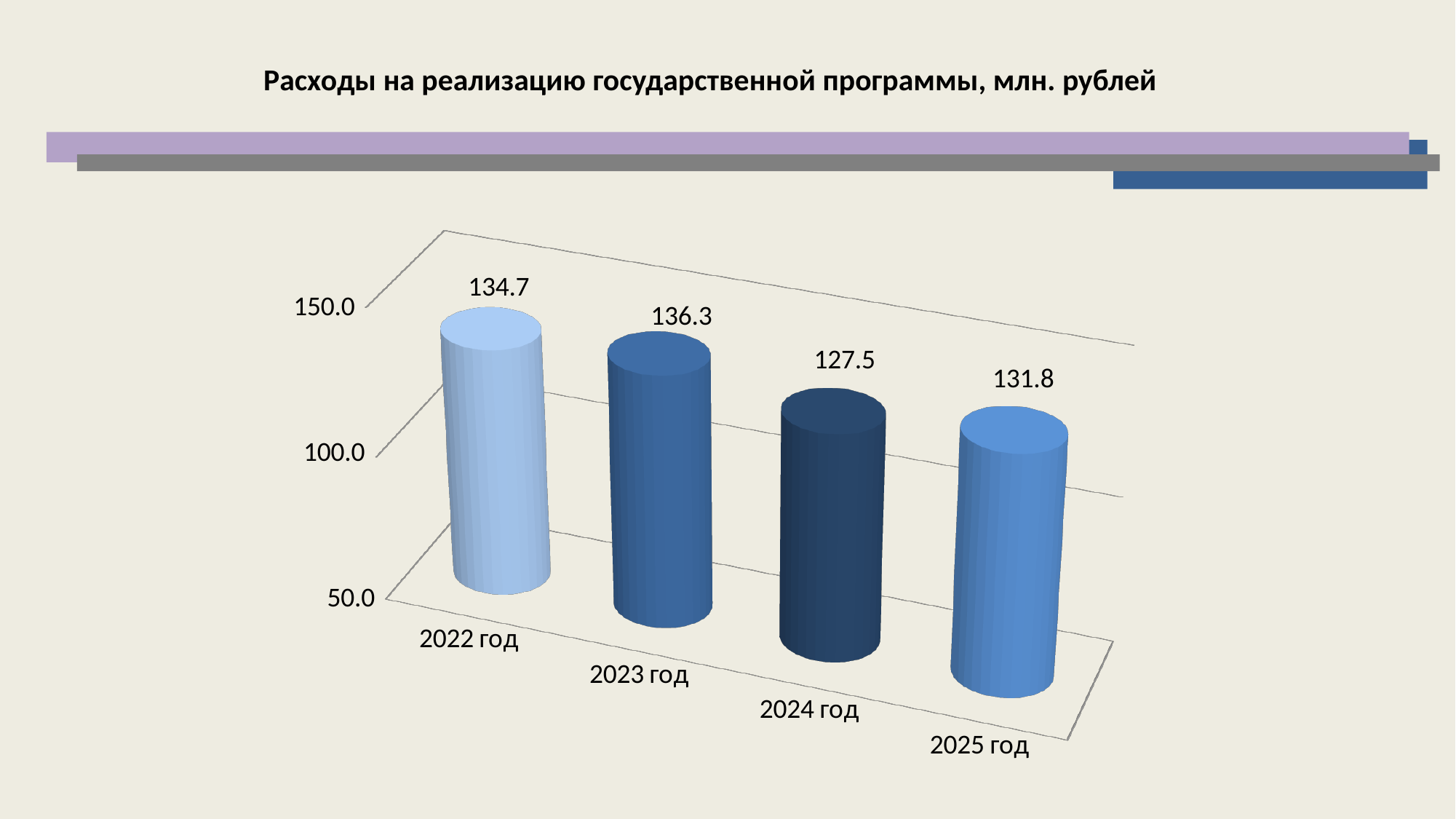
What is the value for 2025 год? 131.8 What is the title of the chart? Расходы на реализацию государственной программы, млн. рублей Which year has the highest value? 2023 год What is the value for 2023 год? 136.3 What kind of chart is shown on the slide? bar chart Which is larger, the value for 2022 год or the value for 2025 год? 2022 год What is the value for 2024 год? 127.5 Which year has the lowest value? 2024 год What is the value for 2022 год? 134.7 What is the difference between the values for 2023 год and 2024 год? 8.8 How many years are shown on the chart? 4 Is the value for 2024 год greater or less than 100.0? greater